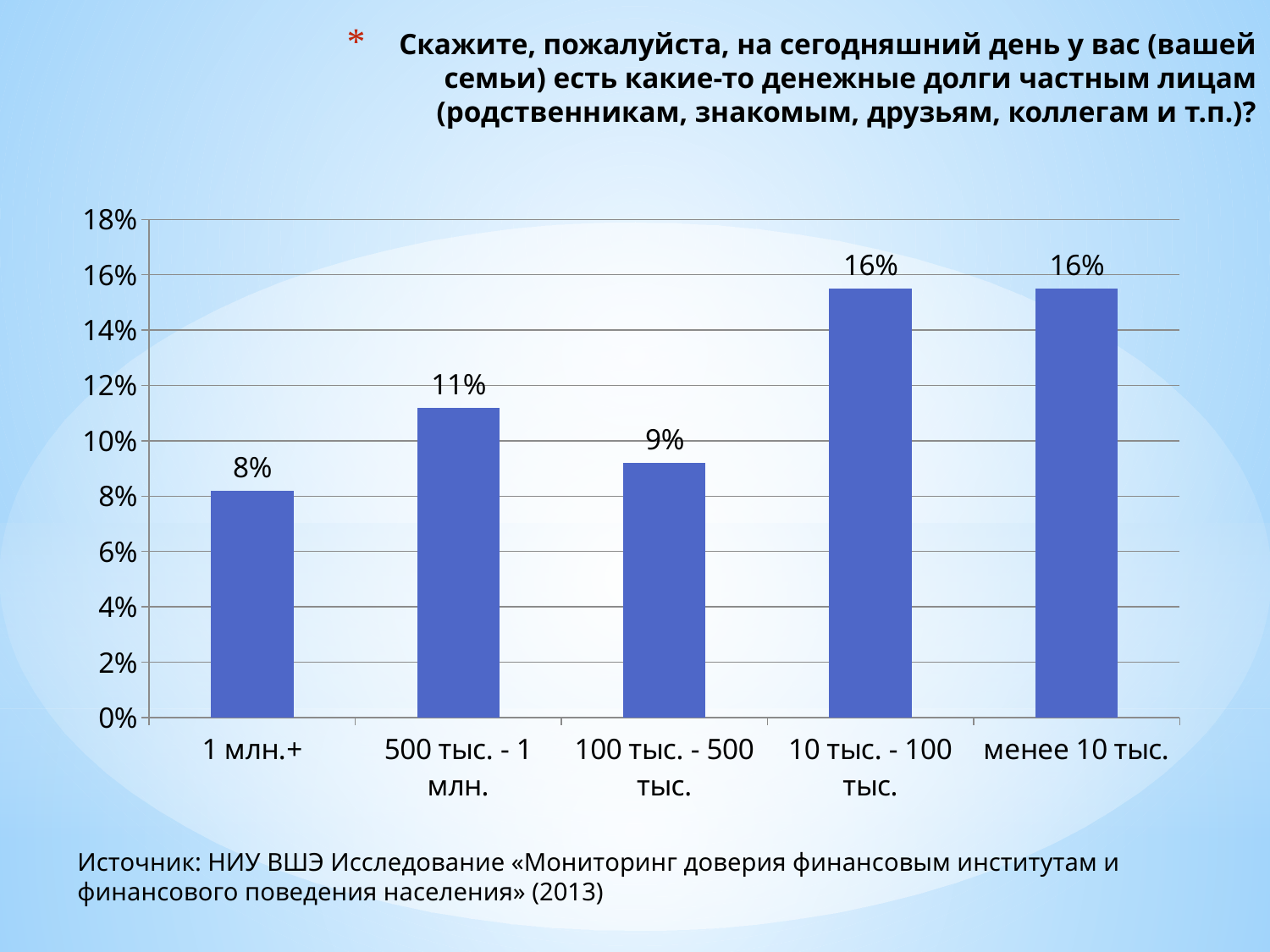
According to the note below the chart, what year is the cited study from? 2013 What is the difference between the values for "10 тыс. - 100 тыс." and "1 млн.+"? 8% What is the value for the category "1 млн.+"? 8% What is the value for the category "500 тыс. - 1 млн."? 11% What kind of chart is shown on the slide? bar chart How many categories are shown on the x axis of the chart? 5 Is the value for "1 млн.+" greater or less than 10%? less Which category has the lowest value? 1 млн.+ Which is larger, the value for "500 тыс. - 1 млн." or the value for "100 тыс. - 500 тыс."? 500 тыс. - 1 млн. What is the value for the category "менее 10 тыс."? 16% What is the difference between the values for "500 тыс. - 1 млн." and "100 тыс. - 500 тыс."? 2% What is the value for the category "100 тыс. - 500 тыс."? 9%